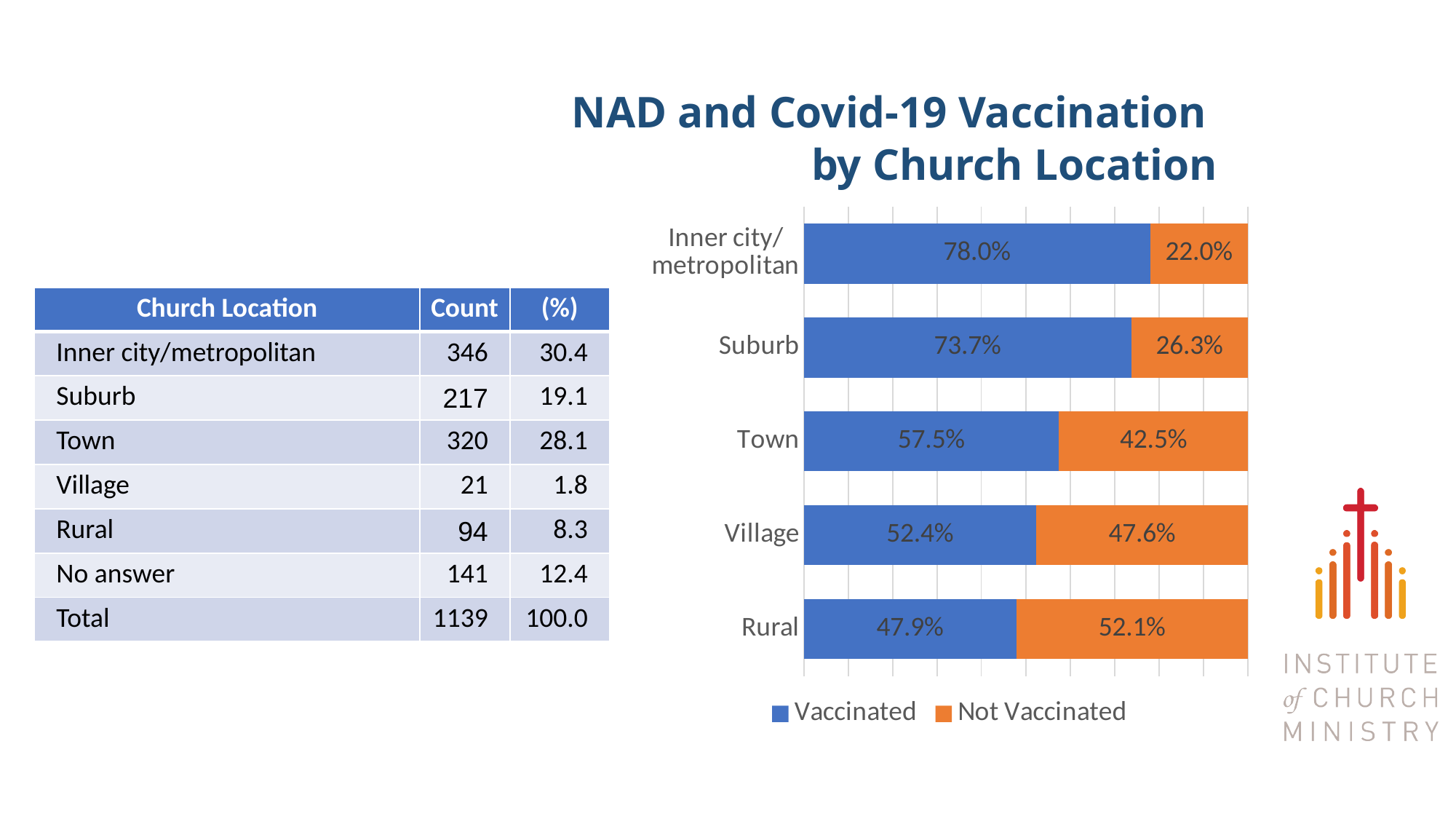
What kind of chart is shown on the slide? Stacked bar chart Which church location has the highest Vaccinated percentage? Inner city/metropolitan Which is larger: the Vaccinated value for Village or the Not Vaccinated value for Village? Vaccinated (52.4%) What is the difference between the Vaccinated percentages for Inner city/metropolitan and Suburb? 4.3% Which church location has the lowest Vaccinated percentage? Rural Which church location has the highest Not Vaccinated percentage? Rural What is the Not Vaccinated value for Suburb? 26.3% What is the Vaccinated value for Town? 57.5% How many series does the legend list? 2 What is the Vaccinated value for Rural? 47.9% How many church location categories are shown in the chart? 5 What is the total of the stacked bar for Town? 100.0%